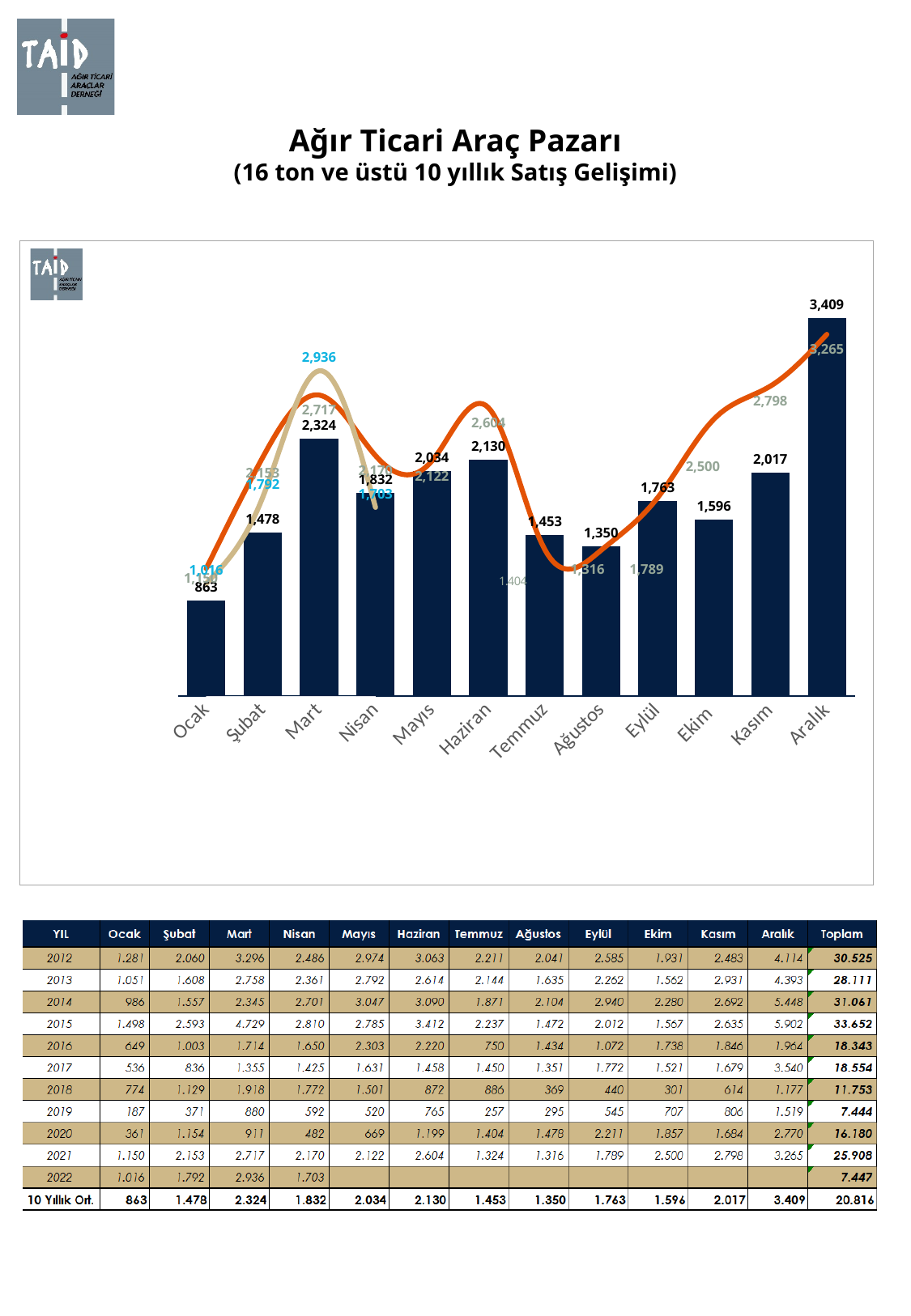
Which bar is taller, Kasım or Ekim? Kasım What kind of chart is used to show the monthly values? combination bar and line chart What is the bar value for Ağustos? 1,350 Do the bar values rise or fall from Ocak to Mart? rise Which month has the highest bar? Aralık How many months are shown on the x axis of the chart? 12 What is the difference between the bar values for Mart and Şubat? 846 What is the bar value for Mart? 2,324 What is the difference between the bar values for Aralık and Ocak? 2,546 What is the bar value for Aralık? 3,409 Which month has the lowest bar? Ocak Which bar is taller, Haziran or Mayıs? Haziran